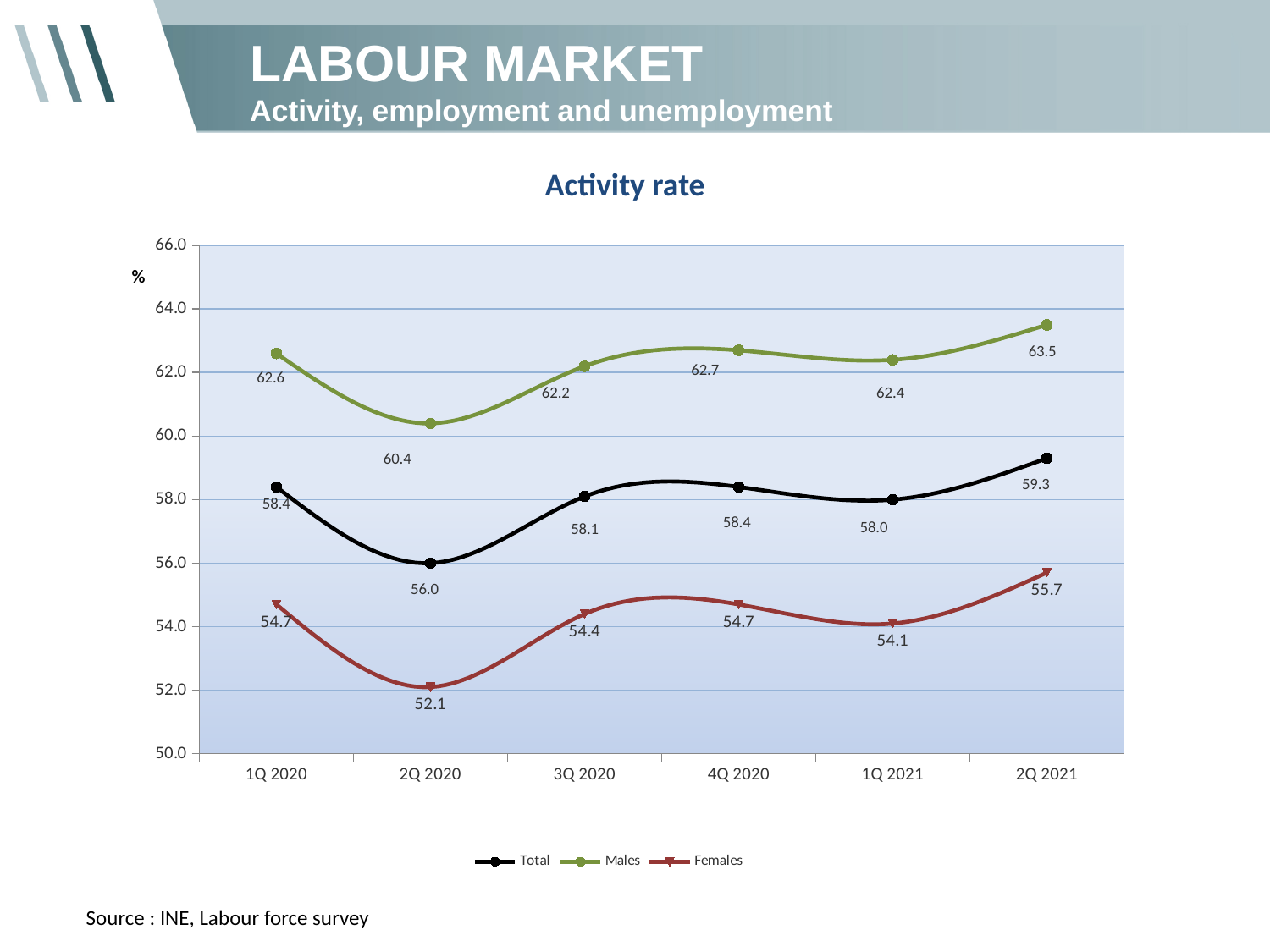
What is the activity rate for Females in 2Q 2020? 52.1 Does the Total activity rate rise or fall from 1Q 2021 to 2Q 2021? Rise What kind of chart is shown? Line chart Which is larger, the Total activity rate in 1Q 2020 or in 4Q 2020? They are equal (58.4) What is the activity rate for Males in 2Q 2021? 63.5 In which quarter is the Females activity rate highest? 2Q 2021 In which quarter is the Males activity rate lowest? 2Q 2020 How many series does the legend list? 3 What is the difference between the Males and Females activity rates in 2Q 2021? 7.8 How many quarters are shown on the x axis? 6 Is the Females activity rate in 1Q 2021 greater or less than 56.0? less What is the Total activity rate in 1Q 2021? 58.0